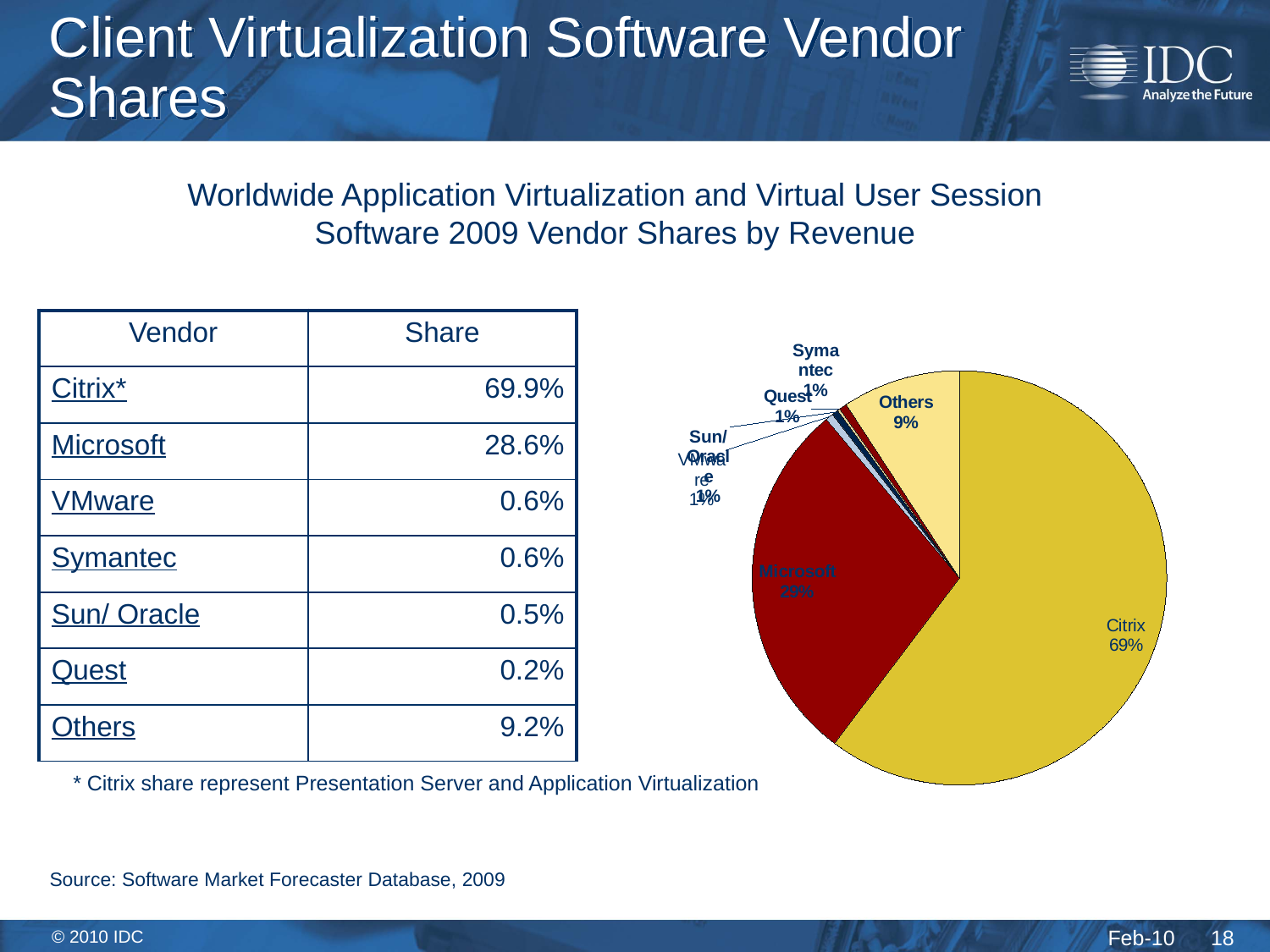
What share does the pie chart show for Citrix? 69% What is the difference between the Citrix and Microsoft shares shown in the pie chart? 40% What share does the pie chart show for Microsoft? 29% Which slice is larger in the pie chart, Microsoft or Others? Microsoft What share does the pie chart show for Symantec? 1% How many slices does the pie chart have? 7 What colour is the Citrix slice in the pie chart? yellow Which vendor has the largest slice in the pie chart? Citrix What share does the pie chart show for Quest? 1% What kind of chart is shown on the slide? pie chart What share does the pie chart show for Others? 9% What is the difference between the Microsoft and Others shares shown in the pie chart? 20%